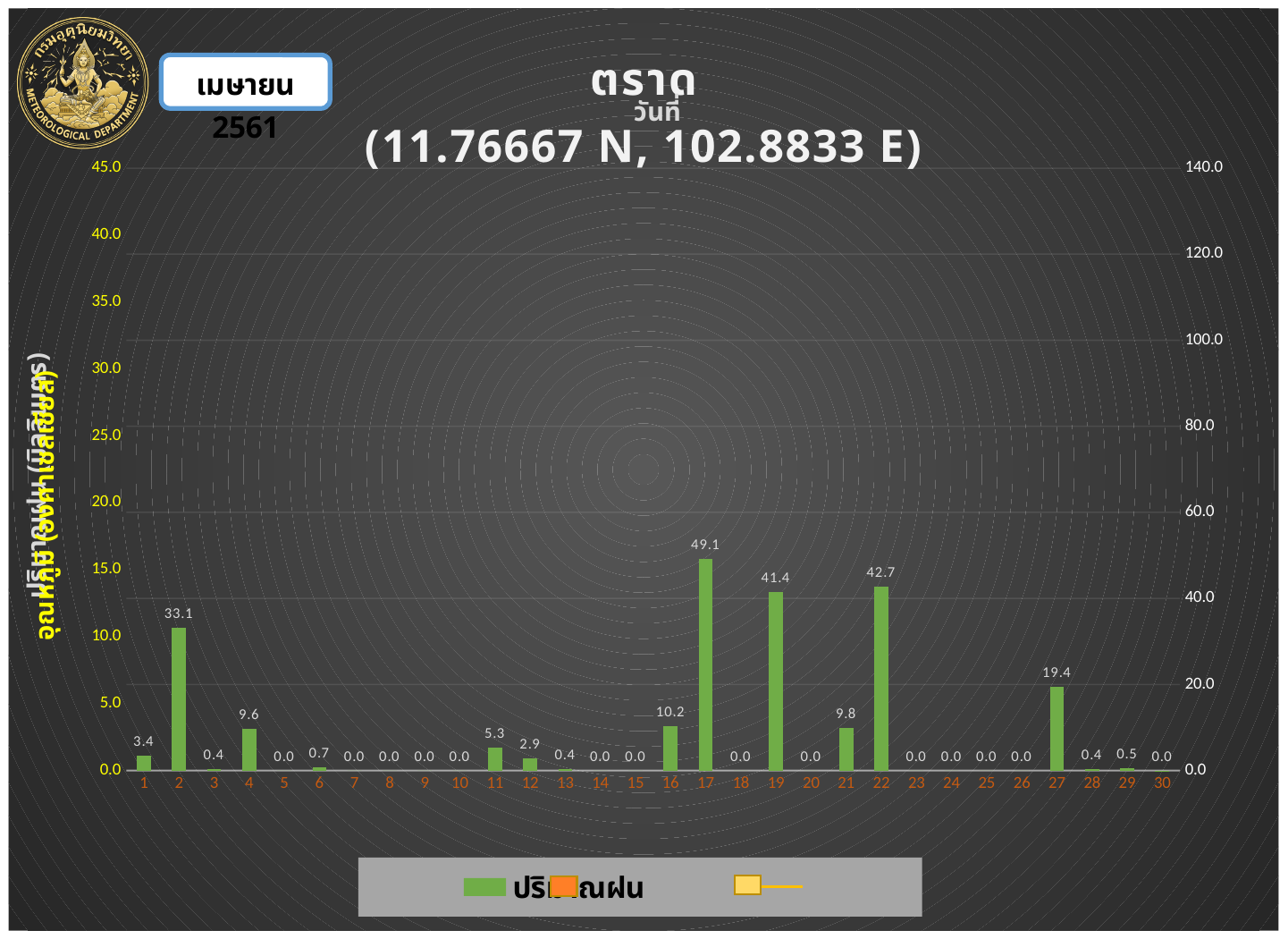
What kind of chart is shown on the slide? bar chart What is the difference between the rainfall values for day 19 and day 2? 8.3 What is the rainfall value shown for day 17? 49.1 How many days are shown on the x axis? 30 What is the rainfall value shown for day 22? 42.7 What station name is given in the chart title? ตราด What is the difference between the rainfall values for day 17 and day 22? 6.4 Which day has the highest rainfall value? 17 What is the rainfall value shown for day 2? 33.1 Is the rainfall value for day 17 greater or less than 40.0 on the right-hand axis? greater What is the rainfall value shown for day 27? 19.4 Which day has the larger rainfall value, day 19 or day 22? 22